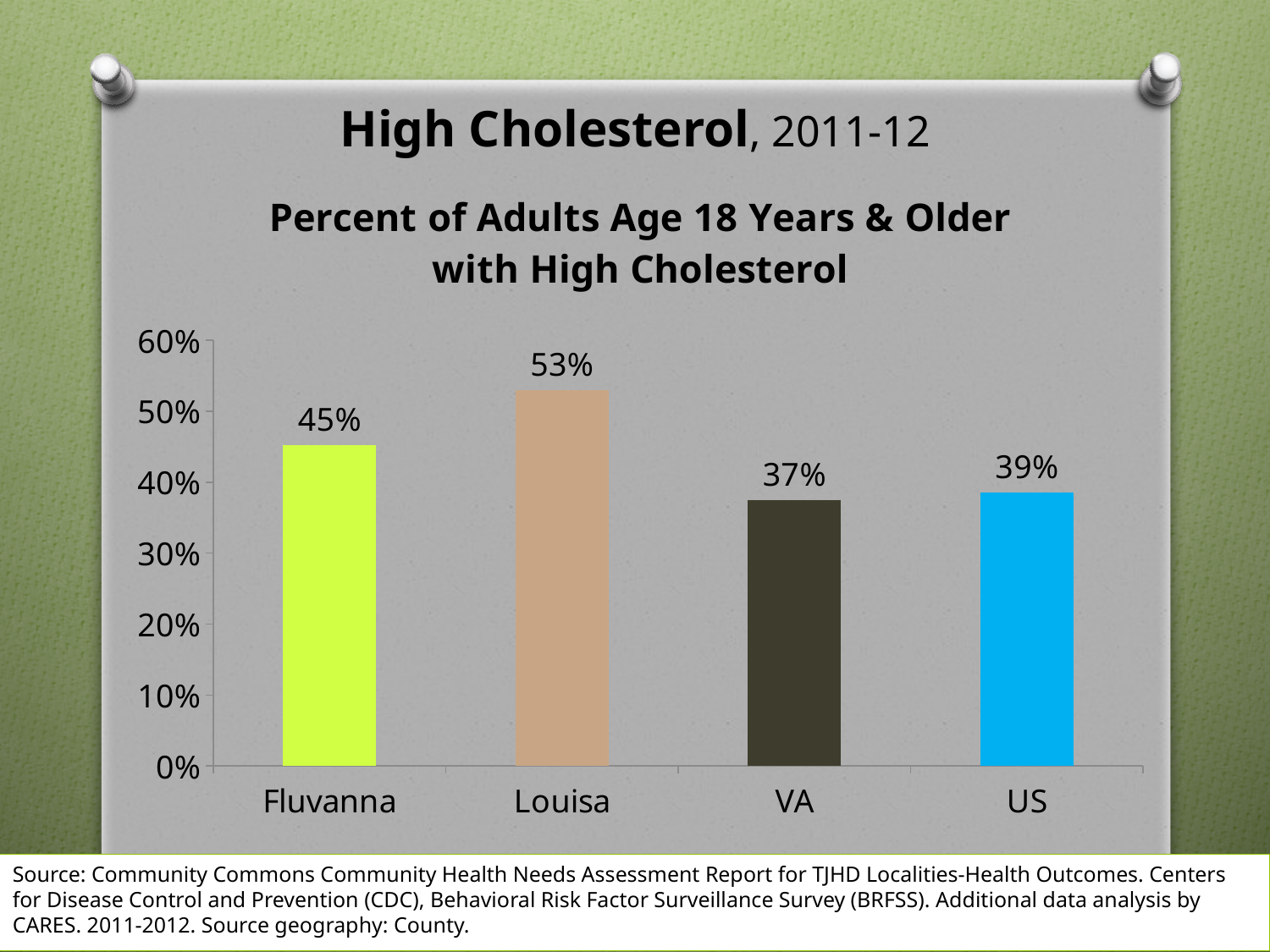
What is the title of the chart? Percent of Adults Age 18 Years & Older with High Cholesterol What is the difference between the values for Louisa and Fluvanna? 8% What kind of chart is shown? Bar chart What is the difference between the values for US and VA? 2% What is the value for US? 39% What is the value for Fluvanna? 45% What is the value for VA? 37% Which category has the lowest value? VA Which is larger, the value for Fluvanna or the value for US? Fluvanna What is the value for Louisa? 53% How many categories are shown on the x axis? 4 Which category has the highest value? Louisa